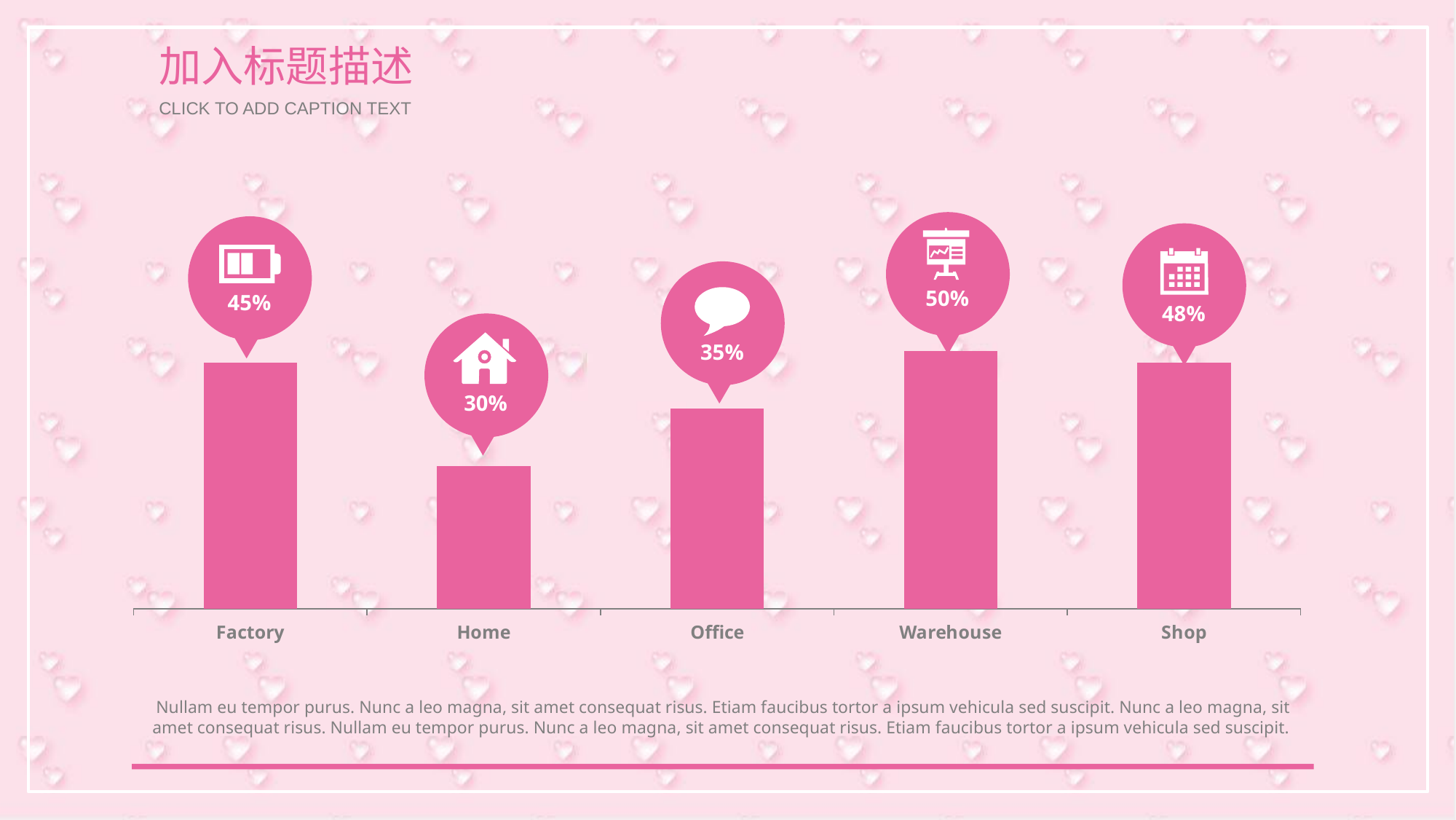
What is the value for Warehouse? 50% Which category has the lowest value? Home What kind of chart is shown on the slide? Bar chart What is the value for Factory? 45% What is the value for Shop? 48% How many categories are shown in the chart? 5 What is the difference between the values for Shop and Factory? 3% Which is larger, the value for Factory or the value for Office? Factory What is the difference between the values for Warehouse and Home? 20% What is the value for Office? 35% Which category has the highest value? Warehouse What is the value for Home? 30%